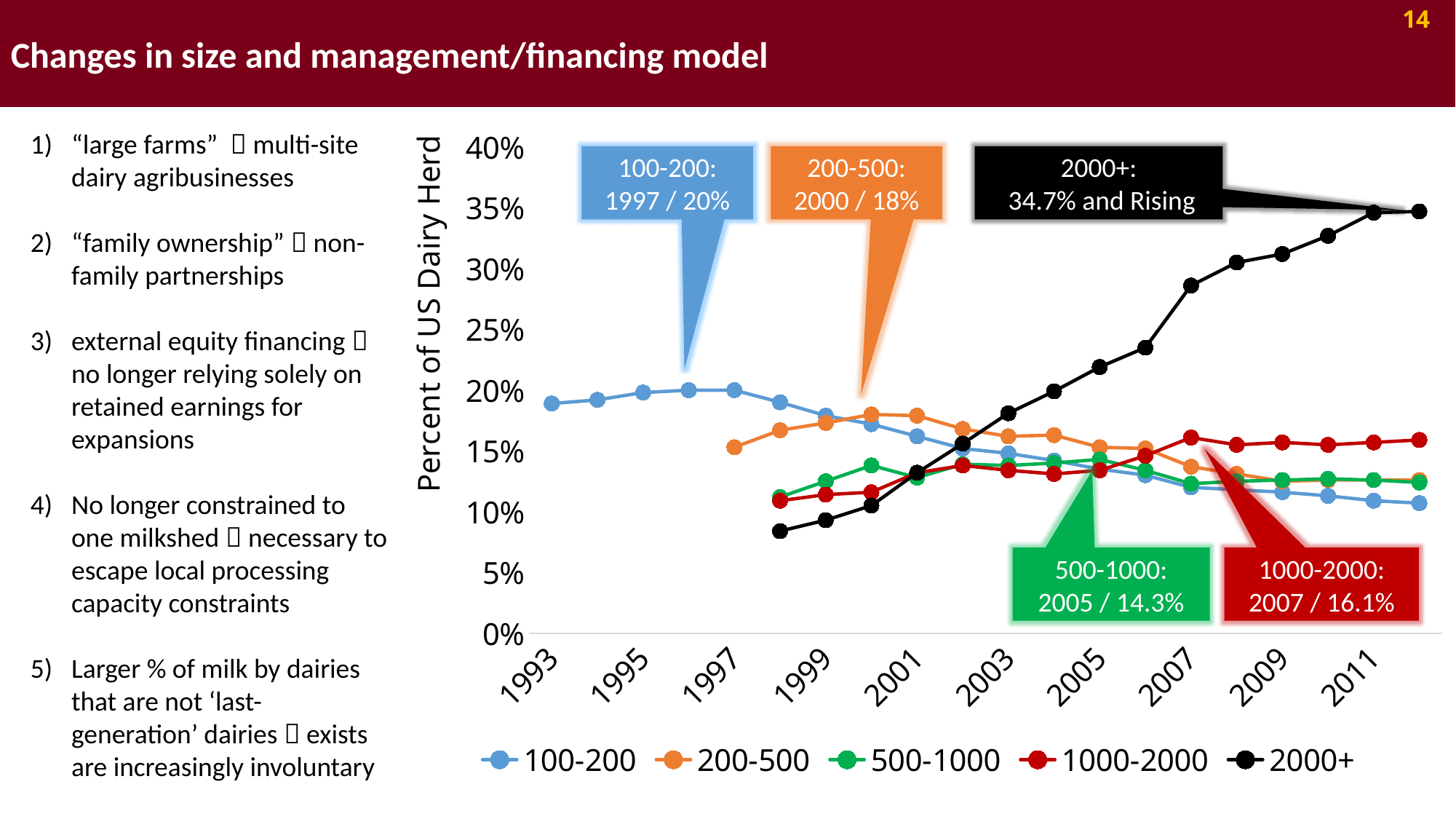
According to the callout, what was the peak value of the 100-200 series, and in which year? 20% in 1997 What is the difference between the 1000-2000 peak in 2007 (16.1%) and the 500-1000 peak in 2005 (14.3%)? 1.8 percentage points Is the value for the 2000+ series in 2001 greater or less than 15%? less What is the label on the vertical axis? Percent of US Dairy Herd Which series has the highest value at the right end of the chart? 2000+ What kind of chart is shown on the slide? line chart What value does the callout give for the 1000-2000 series in 2007? 16.1% What value does the callout give for the 500-1000 series in 2005? 14.3% According to the callout, what value did the 200-500 series reach in 2000? 18% How many series does the legend list? 5 Does the 2000+ series rise or fall over the years shown? rise What is the latest value shown in the callout for the 2000+ series? 34.7%